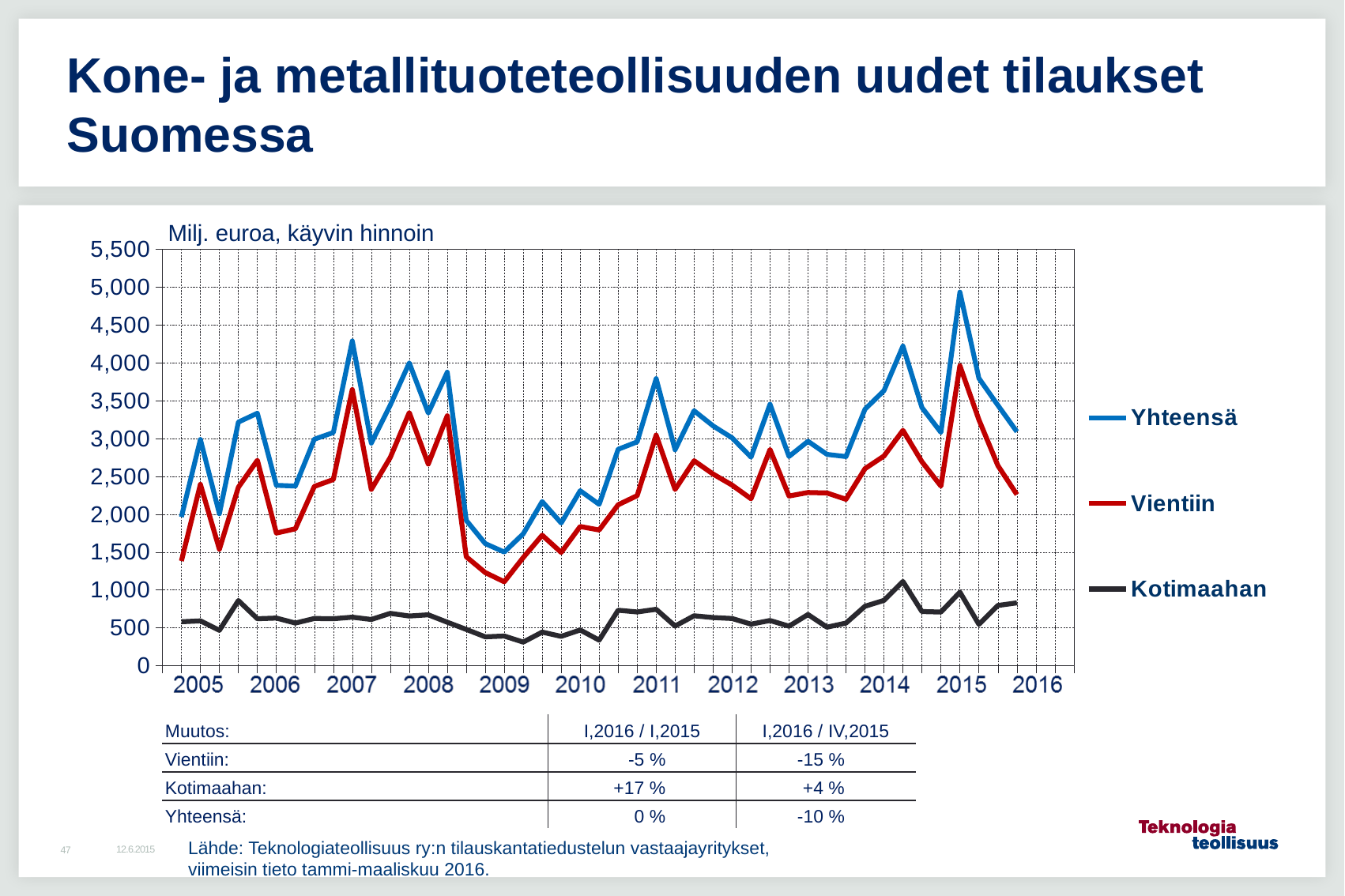
Is the highest value of Kotimaahan greater or less than 1,500? less Do the Yhteensä values rise or fall from the 2015 peak to 2016? fall Is the peak value of Yhteensä in 2015 greater or less than 4,500? greater Is the lowest value of Vientiin in 2009 greater or less than 1,500? less What unit is stated above the chart? Milj. euroa, käyvin hinnoin Which series is plotted with the red line? Vientiin Which series has the lowest values throughout the chart? Kotimaahan Which series has the highest values throughout the chart? Yhteensä What kind of chart is shown on the slide? line chart How many year labels are shown on the x axis? 12 How many series does the legend list? 3 Which is larger in 2007: the peak of Yhteensä or the peak of Vientiin? Yhteensä